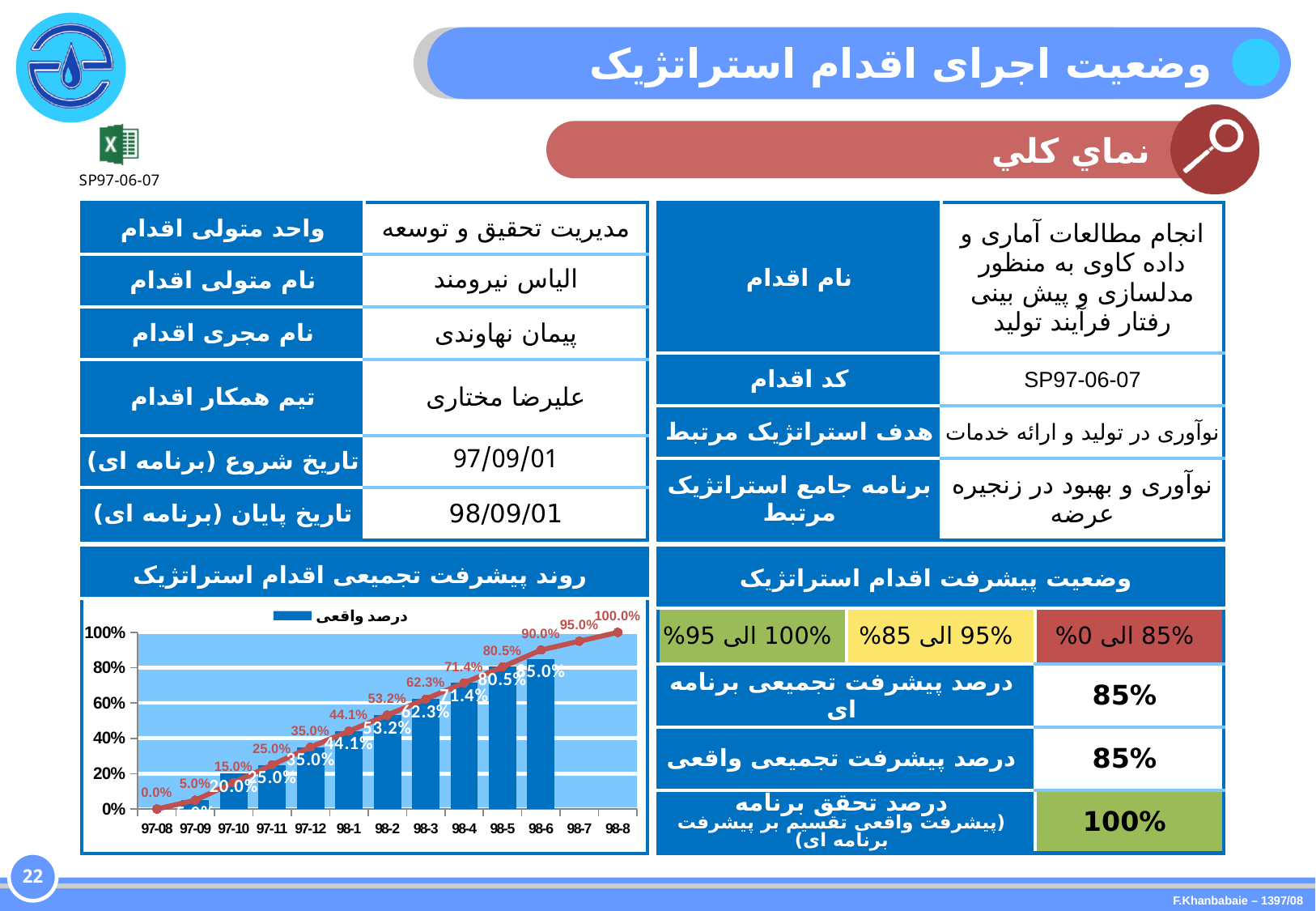
What is the value of the line at 98-8? 100.0% What is the difference between the line value and the bar value at 98-6? 5.0% Do the line values rise or fall from 97-08 to 98-8? Rise What kind of chart is shown on the slide? A combined bar and line chart What is the value of the line at 98-1? 44.1% At which period does the line reach its highest value? 98-8 What is the value of the line at 98-6? 90.0% Is the line value at 98-7 greater or less than 80%? greater How many time periods are shown on the x axis of the chart? 13 What is the value of the line at 97-09? 5.0% What is the title of the chart? روند پیشرفت تجمیعی اقدام استراتژیک What is the value of the bar (درصد واقعی) at 98-6? 85.0%